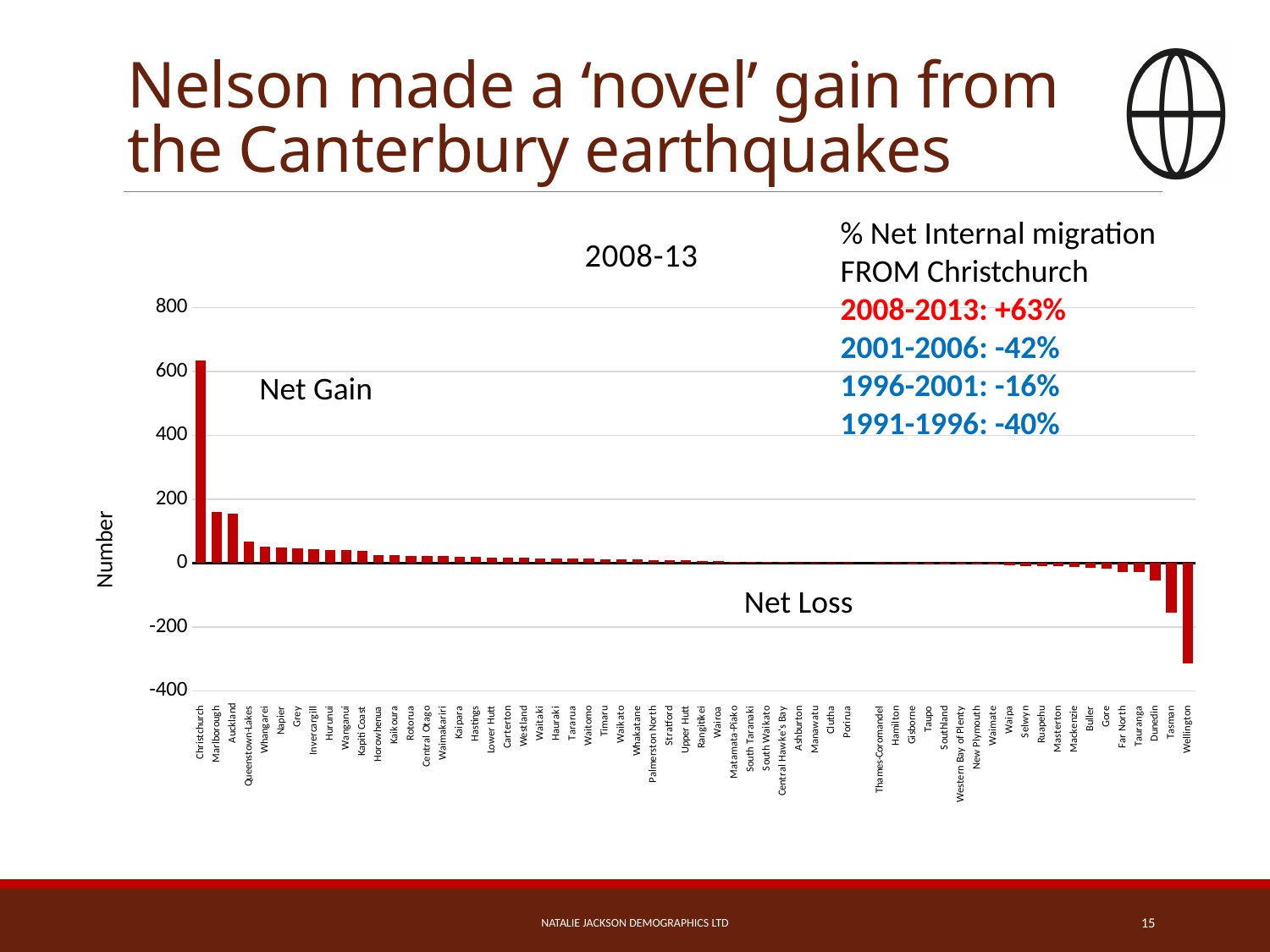
Which has the larger value, Christchurch or Marlborough? Christchurch Which has the larger value, Auckland or Wellington? Auckland Is the value for Christchurch greater or less than 400? greater Do the values rise or fall moving from left to right along the x axis? fall What is the title of the y axis? Number Which category has the highest value in the 2008-13 chart? Christchurch Which category has the lowest value in the 2008-13 chart? Wellington Is the value for Wellington greater or less than -200? less What kind of chart is shown on the slide? bar chart What is the title of the chart? 2008-13 Is the value for Marlborough greater or less than 200? less